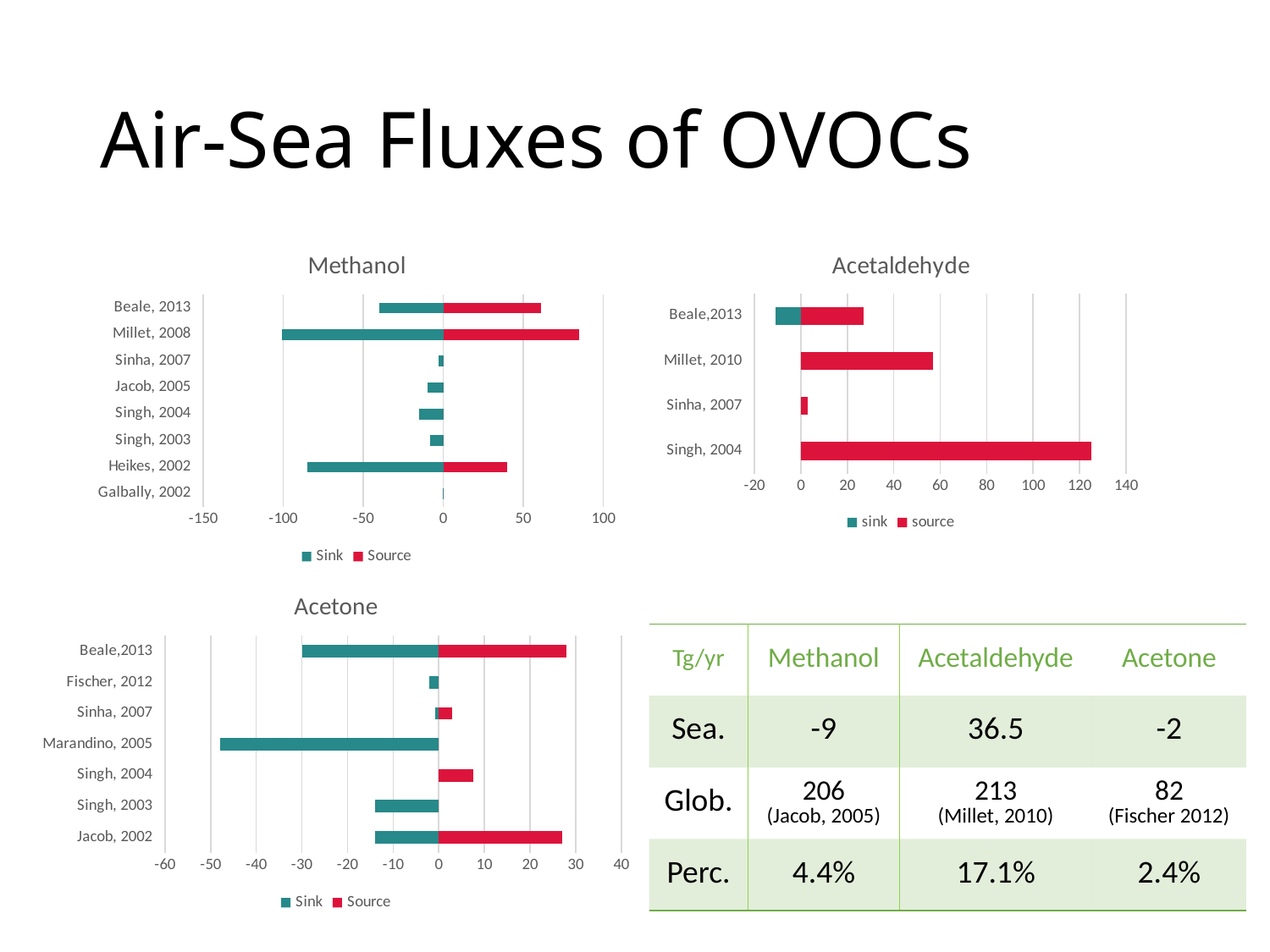
In the Acetaldehyde chart, how many studies are listed on the vertical axis? 4 What kind of chart is the Acetone chart? bar chart In the Acetaldehyde chart, which has the larger Source value, Millet, 2010 or Beale, 2013? Millet, 2010 How many series does the legend of the Acetaldehyde chart list? 2 In the Methanol chart, is the Sink value for Heikes, 2002 greater or less than -50? less In the Acetaldehyde chart, is the Source value for Singh, 2004 greater or less than 100? greater In the Methanol chart, is the Source value for Millet, 2008 greater or less than 50? greater In the Methanol chart, which study has the largest Source value? Millet, 2008 In the Acetaldehyde chart, which study has the largest Source value? Singh, 2004 In the Acetone chart, which study has the lowest (most negative) Sink value? Marandino, 2005 In the Methanol chart, how many studies are listed on the vertical axis? 8